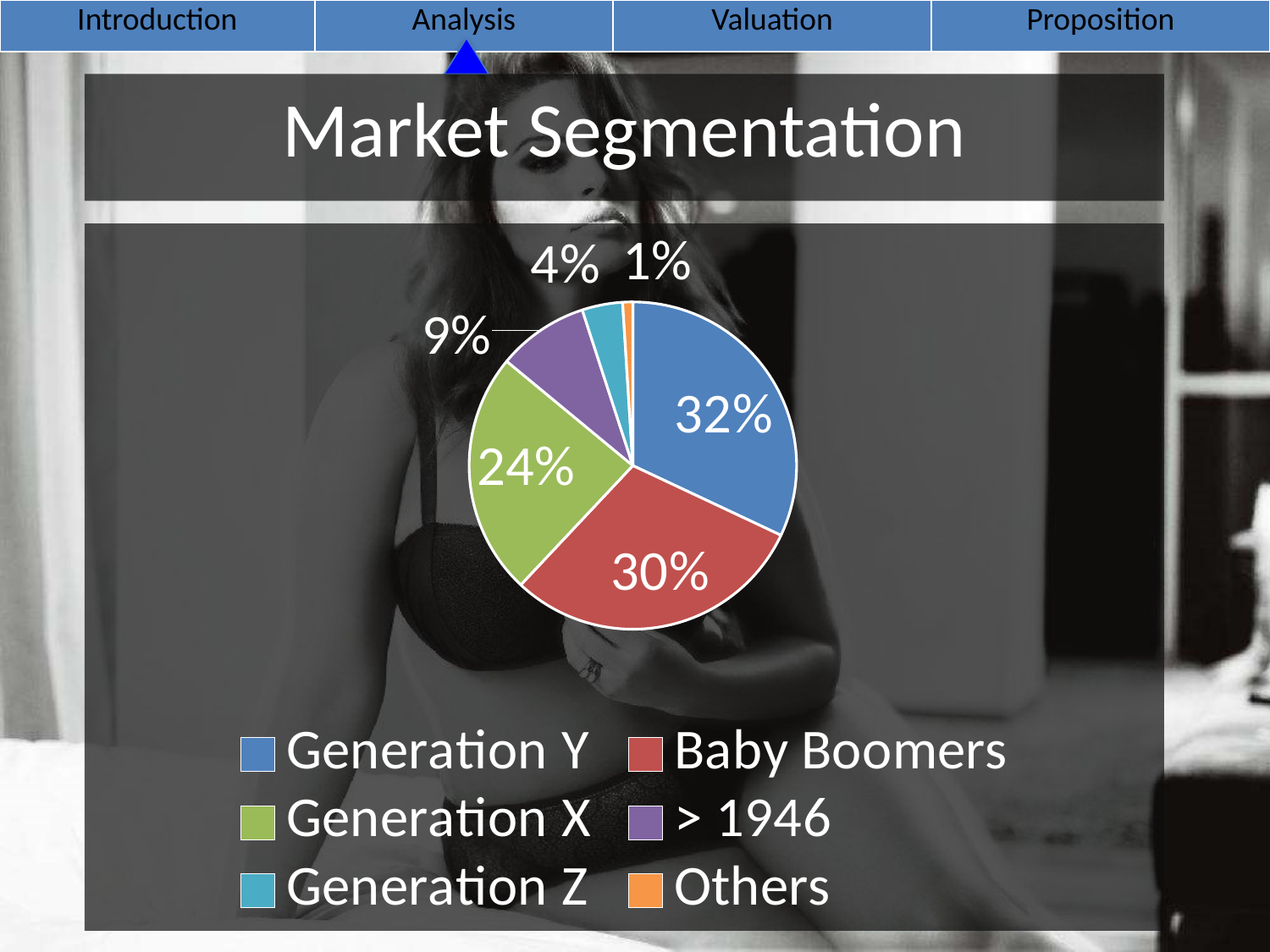
How many segments does the pie chart have? 6 What share of the pie does Generation Z hold? 4% What share of the pie does Generation Y hold? 32% Which segment has the smallest share of the pie? Others What is the title of the slide containing the pie chart? Market Segmentation Which segment has the largest share of the pie? Generation Y What share of the pie does Baby Boomers hold? 30% What is the difference in percentage points between Generation Y and Generation X? 8 What share of the pie does the > 1946 segment hold? 9% What kind of chart is shown on the slide? pie chart What share of the pie does Generation X hold? 24% Which is larger, the share for Baby Boomers or the share for Generation X? Baby Boomers